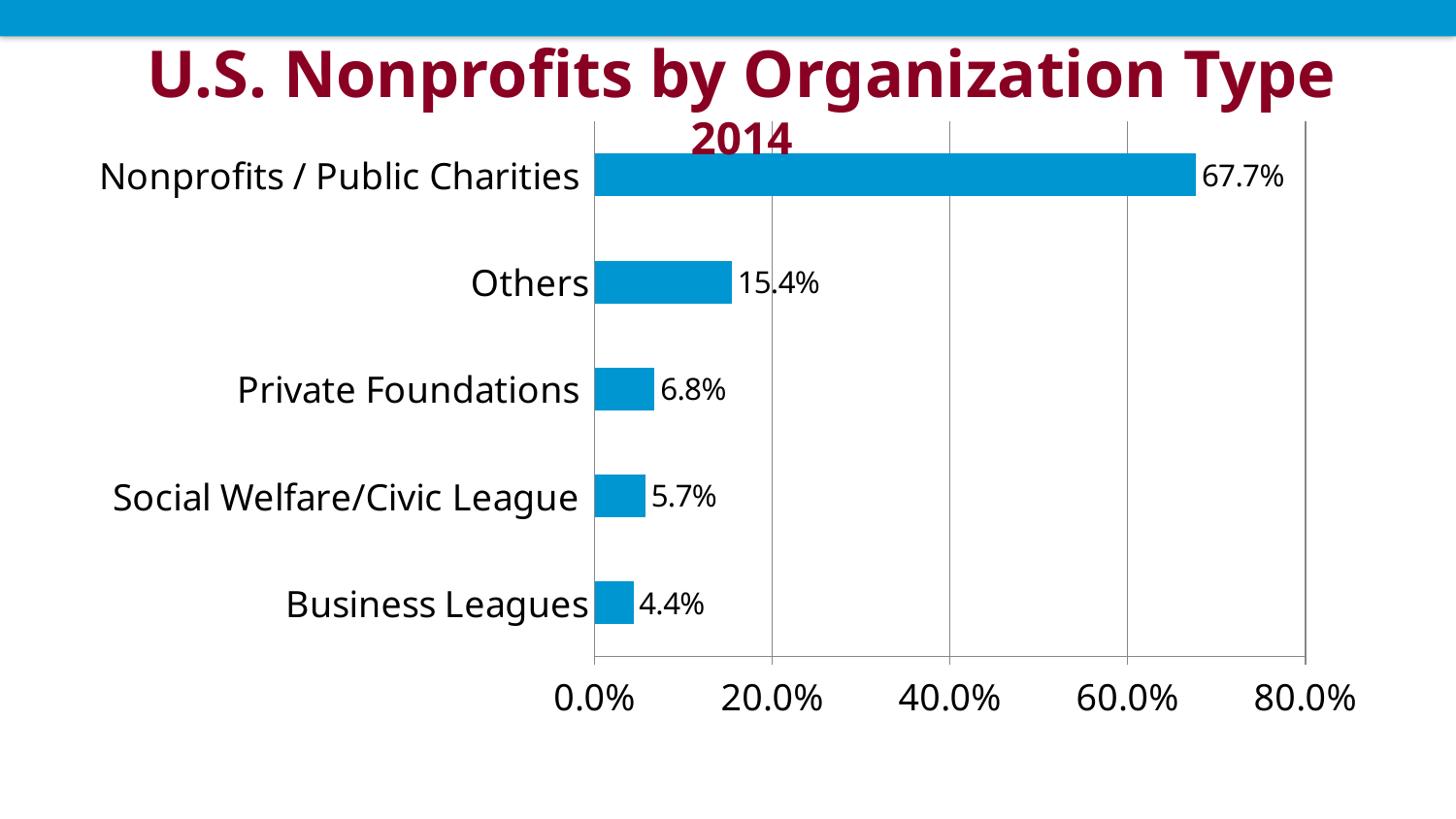
Which organization type has the highest value? Nonprofits / Public Charities How many organization types are shown in the chart? 5 What is the value for Others? 15.4% Is the value for Nonprofits / Public Charities greater or less than 60.0%? greater Which is larger, the value for Private Foundations or the value for Social Welfare/Civic League? Private Foundations Which organization type has the lowest value? Business Leagues What kind of chart is shown on the slide? Bar chart What is the value for Nonprofits / Public Charities? 67.7% What is the difference between the values for Nonprofits / Public Charities and Others? 52.3% What is the value for Private Foundations? 6.8% What is the value for Business Leagues? 4.4% What is the value for Social Welfare/Civic League? 5.7%